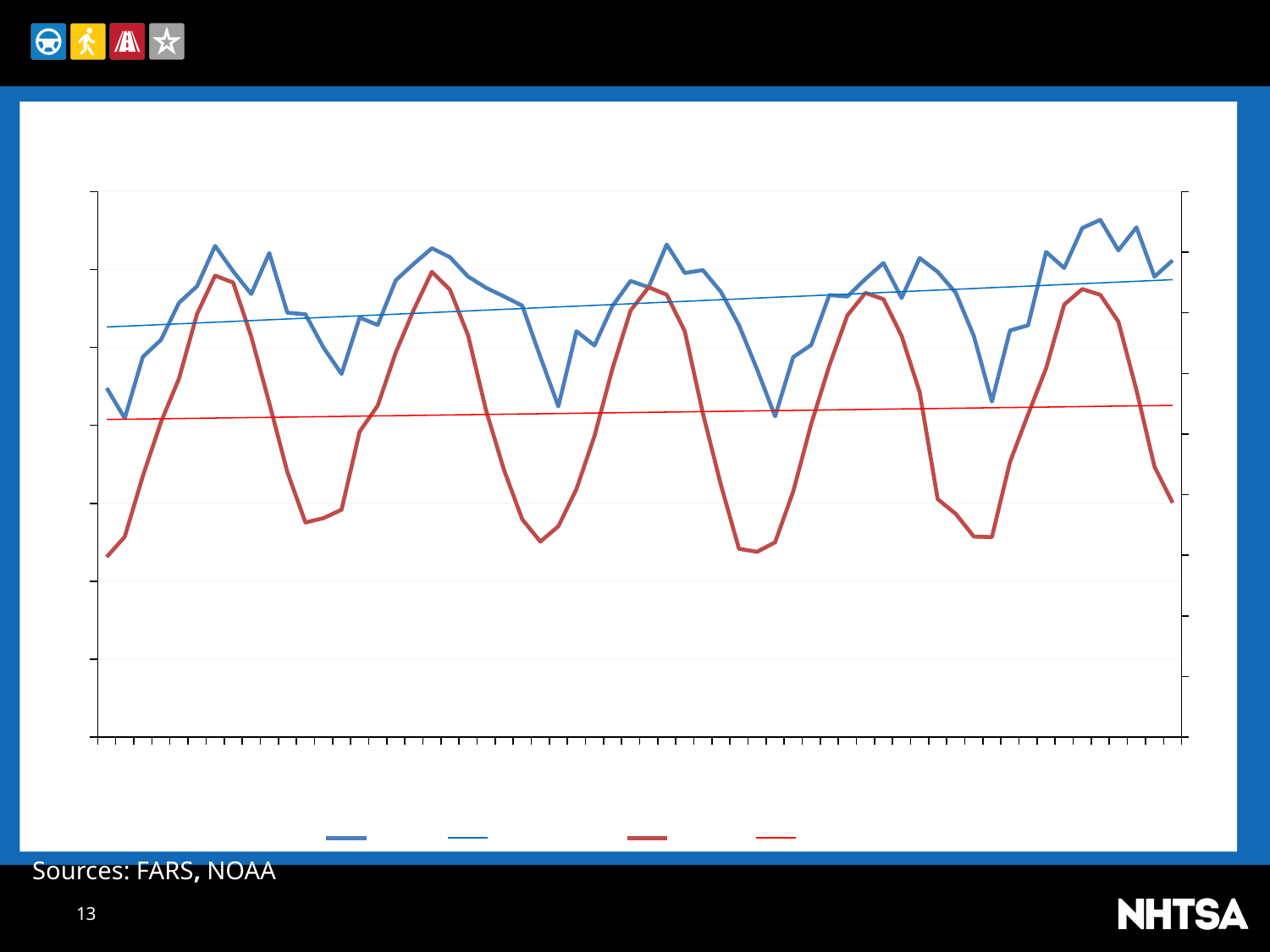
Does the thin straight blue line rise or fall from left to right along the x axis? rise Which line reaches the highest point on the chart, the thick blue line or the thick red line? the thick blue line What kind of chart is shown on the slide? line chart What colours are the lines plotted on the chart? blue and red Does the thin straight red line rise or fall from left to right along the x axis? rise How many series does the legend list? 4 Which colour of line shows the larger repeated up-and-down swings, blue or red? red Which line reaches the lowest point on the chart, the thick blue line or the thick red line? the thick red line